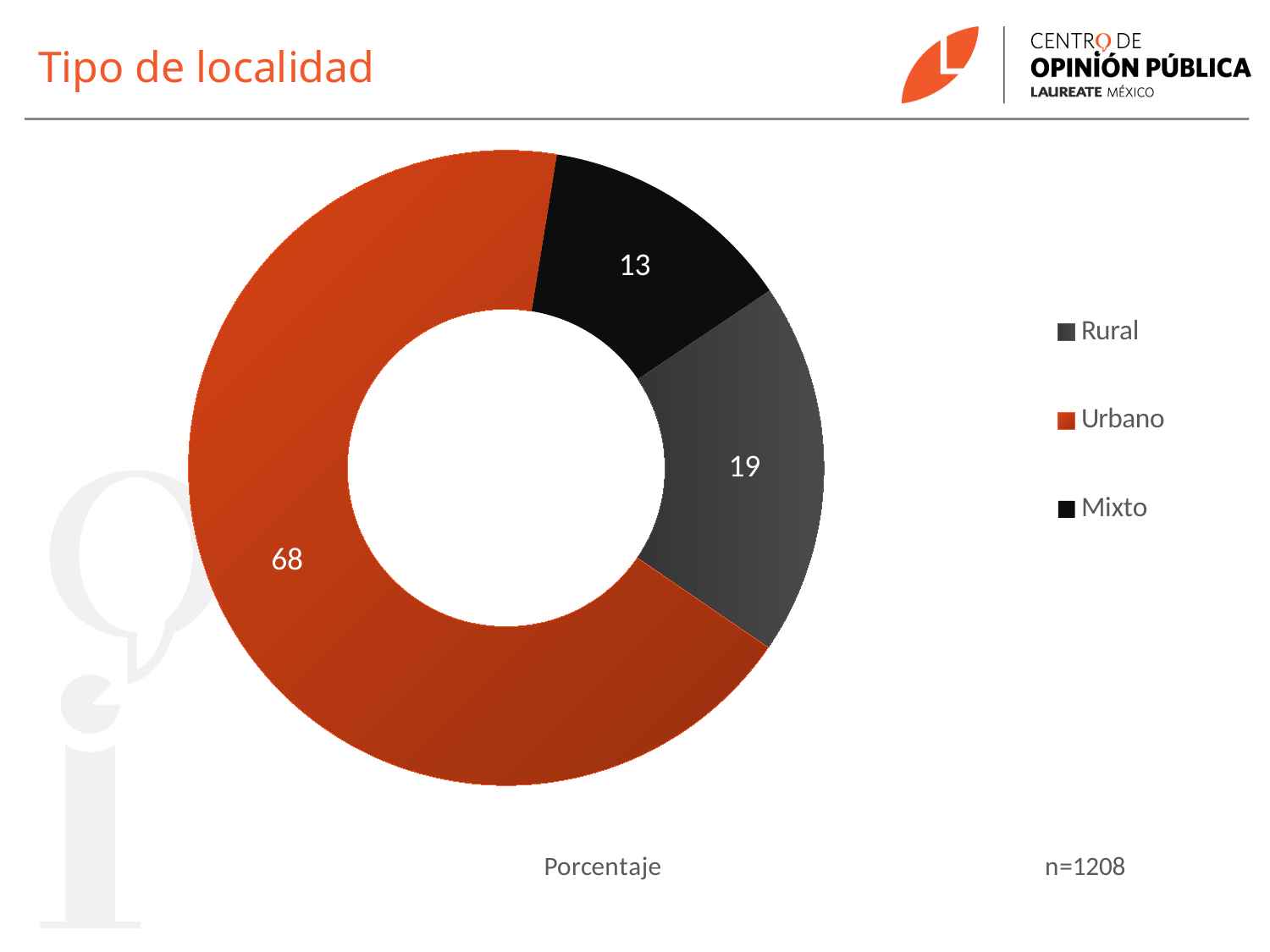
What is the sample size shown on the slide? n=1208 Which is larger, the value for Rural or the value for Mixto? Rural What is the value for Urbano? 68 What kind of chart is shown on the slide? Doughnut chart What is the difference between the values for Urbano and Rural? 49 What is the title of the slide? Tipo de localidad What is the value for Rural? 19 What is the value for Mixto? 13 Which category has the highest value? Urbano How many categories are shown in the chart? 3 Which category has the lowest value? Mixto What is the difference between the values for Rural and Mixto? 6